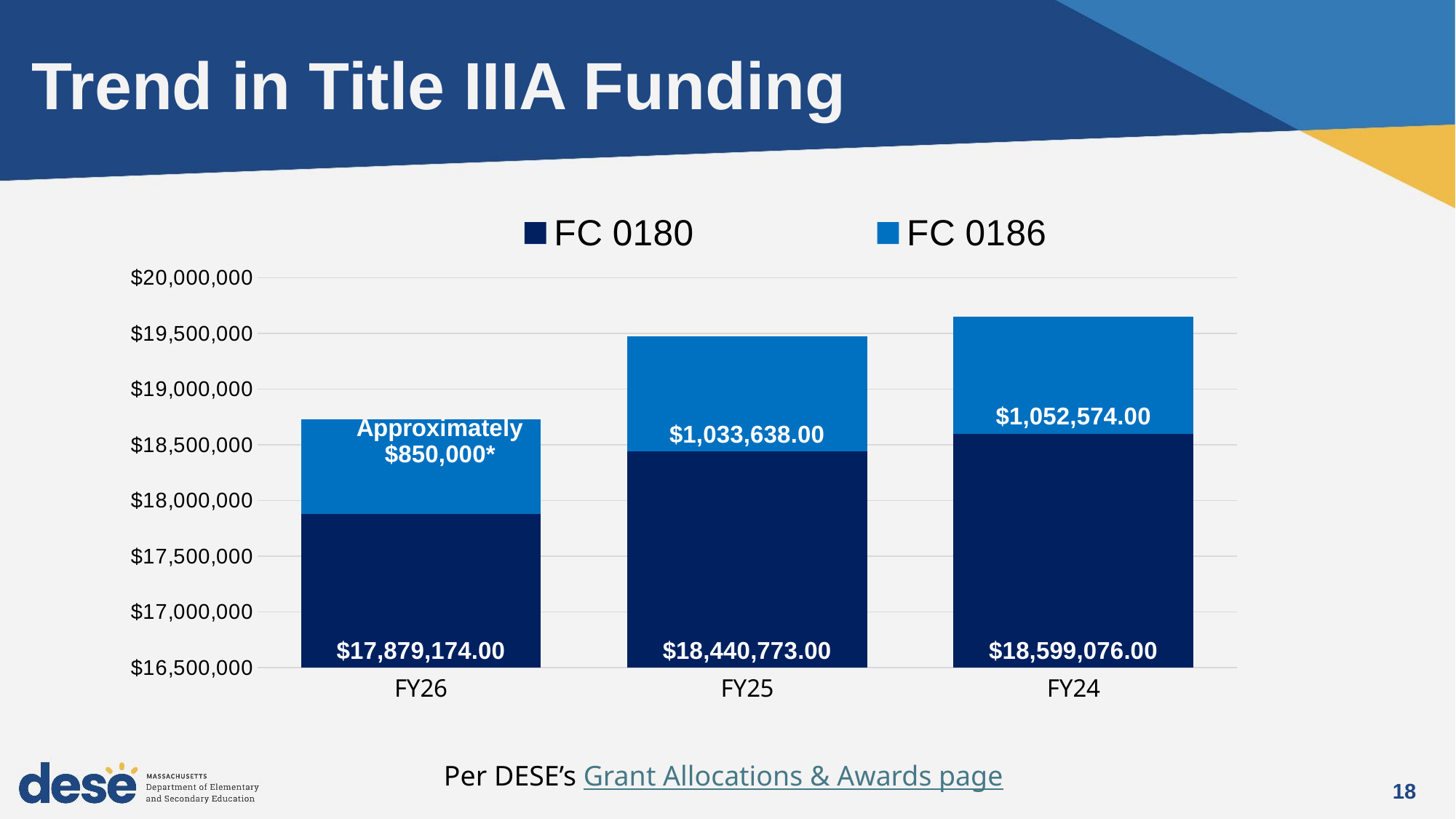
What is the difference between the FC 0186 values for FY24 and FY25? $18,936.00 What is the FC 0186 value for FY24? $1,052,574.00 What kind of chart is shown on the slide? Stacked bar chart How many fiscal years are shown on the x axis? 3 What is the FC 0180 value for FY25? $18,440,773.00 Which fiscal year has the lowest FC 0180 value? FY26 What is the difference between the FC 0180 values for FY24 and FY25? $158,303.00 What is the total of the stacked bar for FY25? $19,474,411.00 Which is larger, the FC 0186 value for FY25 or for FY24? FY24 Which fiscal year has the highest FC 0180 value? FY24 What label is shown for the FC 0186 segment in FY26? Approximately $850,000* How many series does the legend list? 2